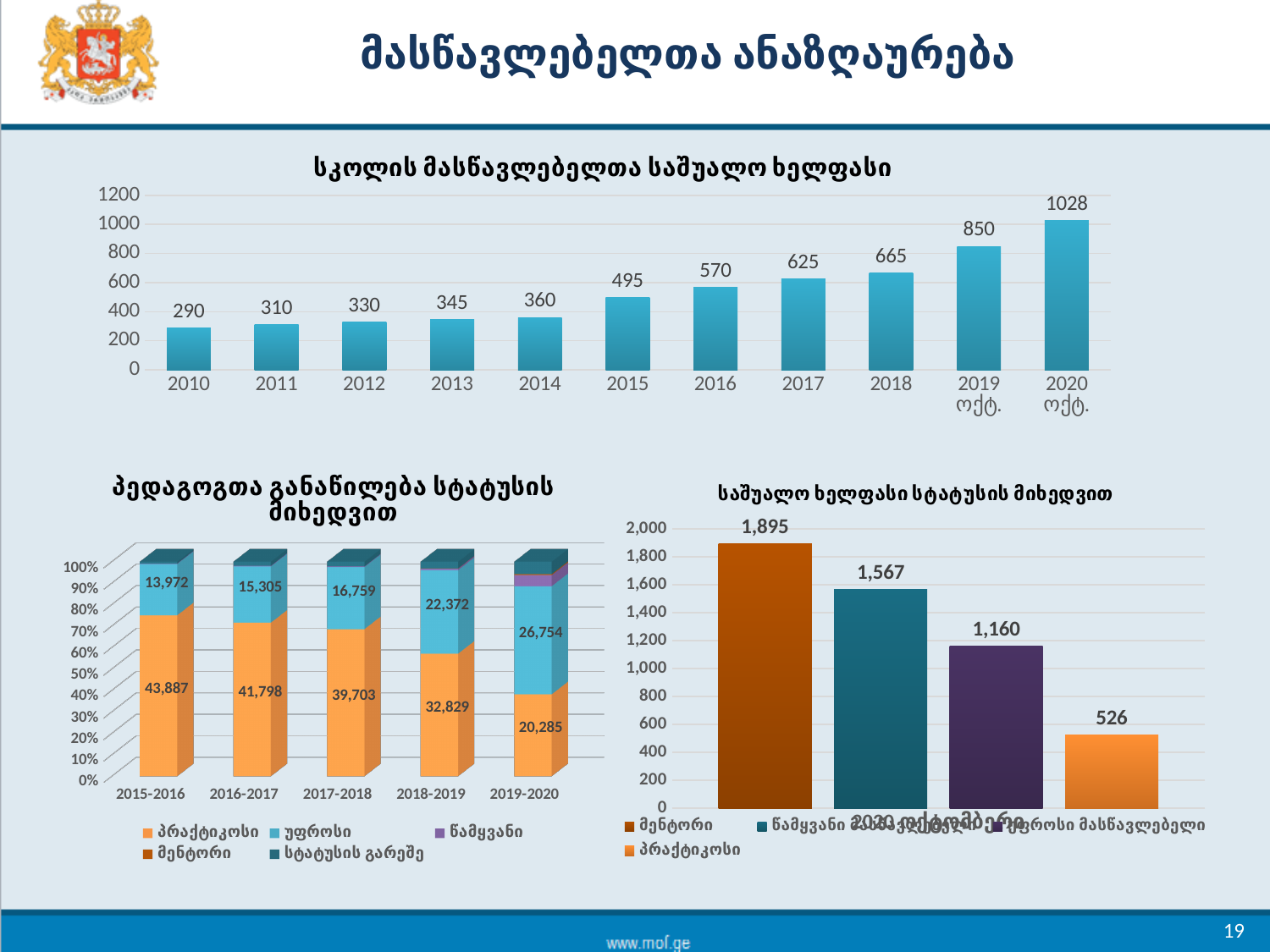
In the bottom-left chart (პედაგოგთა განაწილება სტატუსის მიხედვით), what is the უფროსი value for 2019-2020? 26,754 In the top chart (სკოლის მასწავლებელთა საშუალო ხელფასი), do the values rise or fall from 2010 to 2020? rise In the top chart (სკოლის მასწავლებელთა საშუალო ხელფასი), which year has the highest value? 2020 ოქტ. How many bars are in the top chart (სკოლის მასწავლებელთა საშუალო ხელფასი)? 11 What kind of chart is the bottom-right chart (საშუალო ხელფასი სტატუსის მიხედვით)? bar chart In the bottom-right chart (საშუალო ხელფასი სტატუსის მიხედვით), which category has the lowest value? პრაქტიკოსი In the top chart (სკოლის მასწავლებელთა საშუალო ხელფასი), what is the difference between the 2020 ოქტ. value and the 2019 ოქტ. value? 178 In the bottom-right chart (საშუალო ხელფასი სტატუსის მიხედვით), what is the value for მენტორი? 1,895 How many series does the legend of the bottom-left chart (პედაგოგთა განაწილება სტატუსის მიხედვით) list? 5 In the top chart (სკოლის მასწავლებელთა საშუალო ხელფასი), what is the value for 2010? 290 In the bottom-left chart (პედაგოგთა განაწილება სტატუსის მიხედვით), what is the პრაქტიკოსი value for 2015-2016? 43,887 In the top chart (სკოლის მასწავლებელთა საშუალო ხელფასი), what is the value for 2015? 495